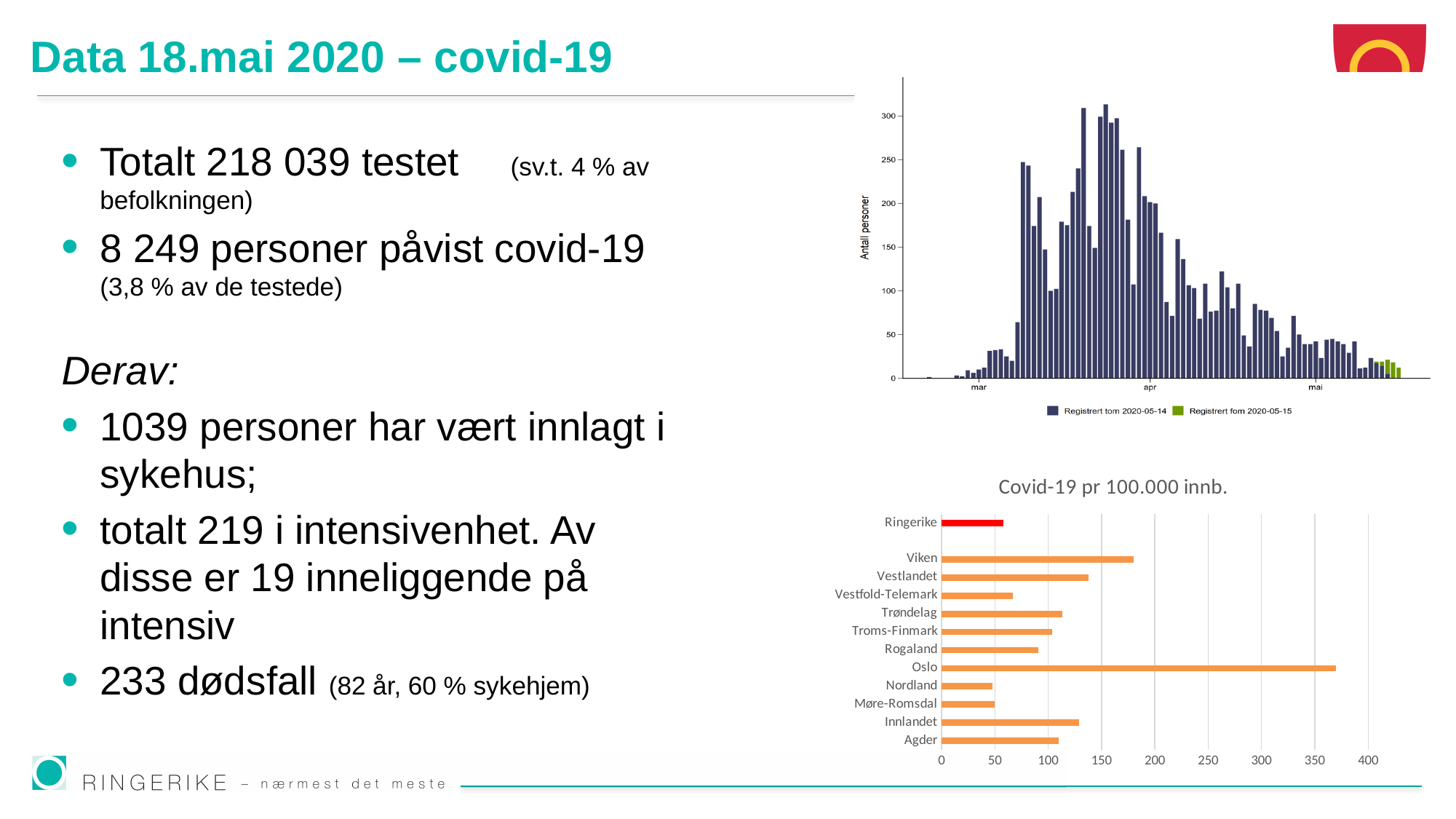
In the chart titled 'Covid-19 pr 100.000 innb.', which category has the highest value? Oslo In the chart titled 'Covid-19 pr 100.000 innb.', is the value for Ringerike greater or less than 100? less In the chart titled 'Covid-19 pr 100.000 innb.', how many categories are shown? 12 In the chart titled 'Covid-19 pr 100.000 innb.', is the value for Oslo greater or less than 350? greater In the top-right chart with the y axis 'Antall personer', do the values rise or fall from apr to mai? fall In the chart titled 'Covid-19 pr 100.000 innb.', which is larger, the value for Viken or the value for Vestlandet? Viken In the chart titled 'Covid-19 pr 100.000 innb.', which bar is coloured red? Ringerike What kind of chart is the chart titled 'Covid-19 pr 100.000 innb.'? bar chart In the top-right chart with the y axis 'Antall personer', how many series does the legend list? 2 In the chart titled 'Covid-19 pr 100.000 innb.', is the value for Innlandet greater or less than 100? greater In the chart titled 'Covid-19 pr 100.000 innb.', which is larger, the value for Trøndelag or the value for Nordland? Trøndelag